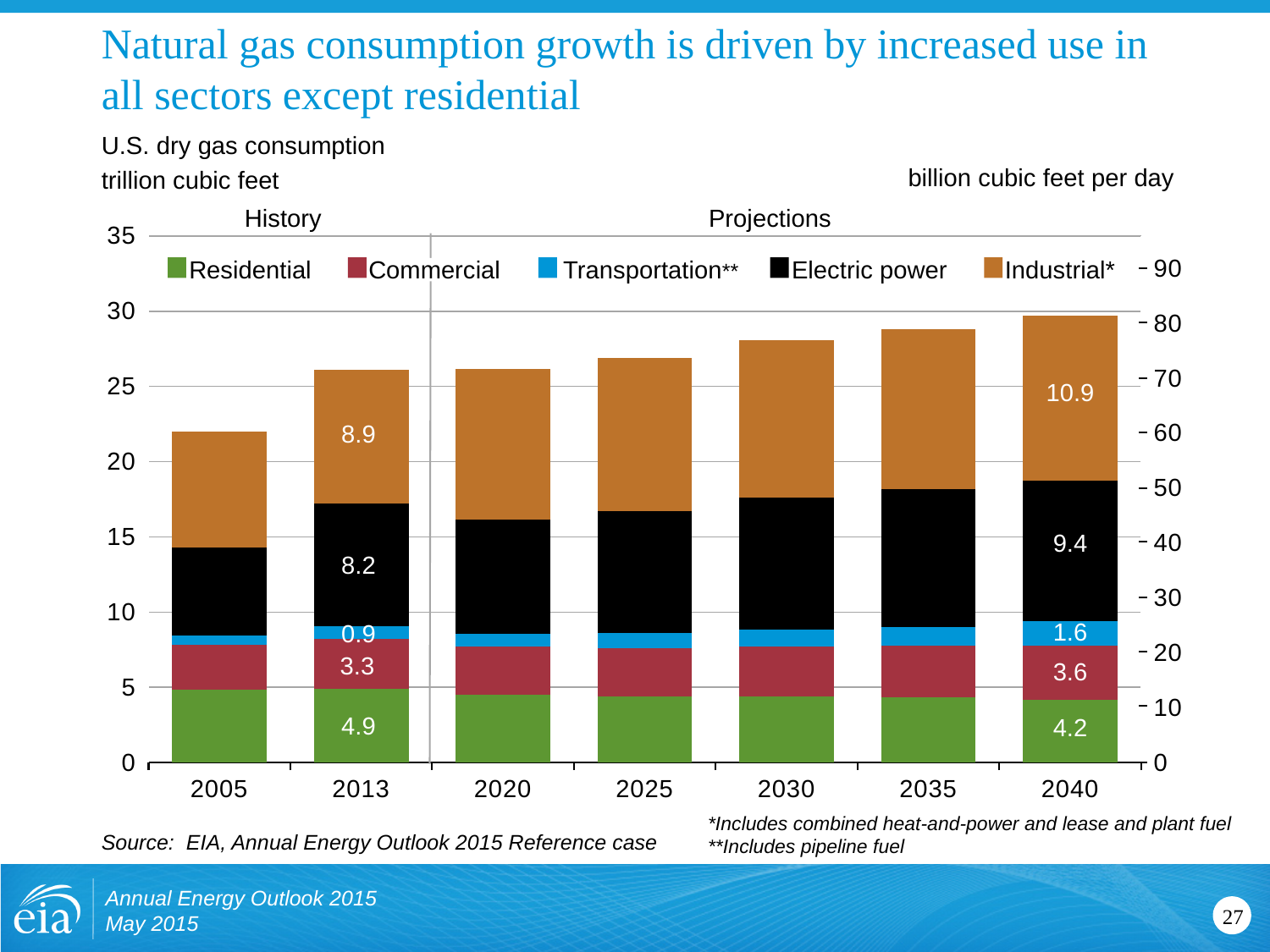
How many series does the legend list? 5 What kind of chart is shown on the slide? Stacked bar chart What is the Residential value for 2013? 4.9 What is the Transportation** value for 2013? 0.9 Which is larger, the Residential value for 2013 or for 2040? 2013 What is the total of the stacked bar for 2040? 29.7 Which year has the highest total bar? 2040 Which year has the lowest total bar? 2005 What is the total of the stacked bar for 2013? 26.1 What is the Industrial* value for 2040? 10.9 What is the difference between the Industrial* values for 2040 and 2013? 2.0 What is the Electric power value for 2040? 9.4